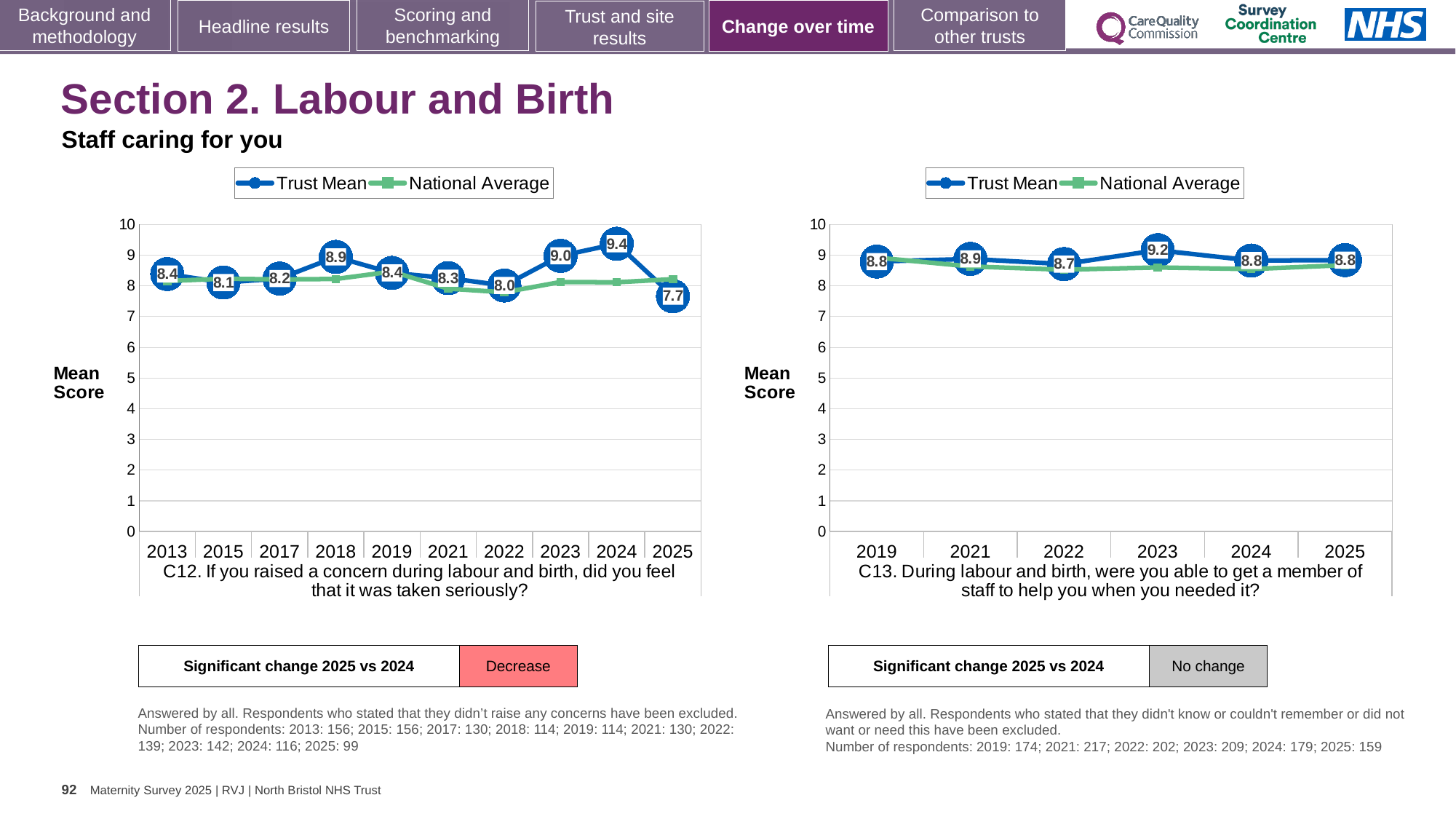
What kind of chart is the C12 chart on the left? Line chart In the C12 chart on the left, what is the Trust Mean for 2025? 7.7 In the C12 chart on the left, which year has the lowest Trust Mean? 2025 In the C13 chart on the right, is the Trust Mean for 2022 greater or less than the Trust Mean for 2021? less How many series does the legend of the C13 chart on the right list? 2 In the C12 chart on the left, what is the Trust Mean for 2024? 9.4 In the C12 chart on the left, what is the difference between the Trust Mean for 2024 and 2025? 1.7 In the C13 chart on the right, which year has the lowest Trust Mean? 2022 In the C13 chart on the right, which year has the highest Trust Mean? 2023 In the C13 chart on the right, what is the Trust Mean for 2023? 9.2 In the C12 chart on the left, which year has the highest Trust Mean? 2024 In the C12 chart on the left, how many years are shown on the x axis? 10